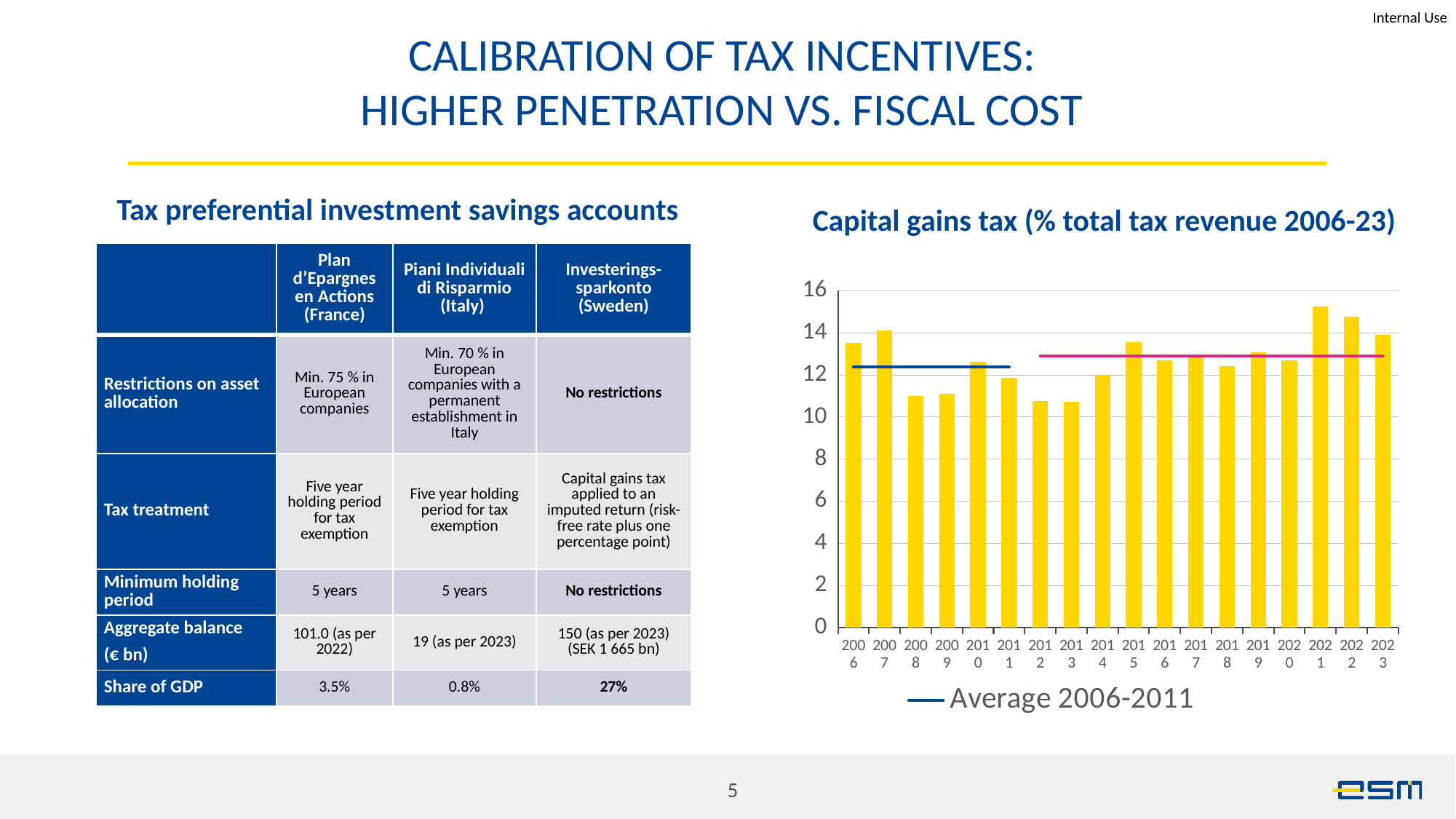
In the capital gains tax chart, which year has the larger value, 2021 or 2008? 2021 In the capital gains tax chart, is the value for 2006 greater or less than 12? greater In the capital gains tax chart, is the value for 2021 greater or less than 14? greater Which year has the highest bar in the capital gains tax chart? 2021 In the capital gains tax chart, is the value for 2008 greater or less than 12? less In the capital gains tax chart, which year has the larger value, 2007 or 2009? 2007 How many years (bars) are plotted in the capital gains tax chart? 18 In the capital gains tax chart, do the values rise or fall from 2021 to 2023? fall How many entries does the legend of the capital gains tax chart list? 1 What kind of chart is shown under the title 'Capital gains tax (% total tax revenue 2006-23)'? bar chart What is the legend entry shown below the capital gains tax chart? Average 2006-2011